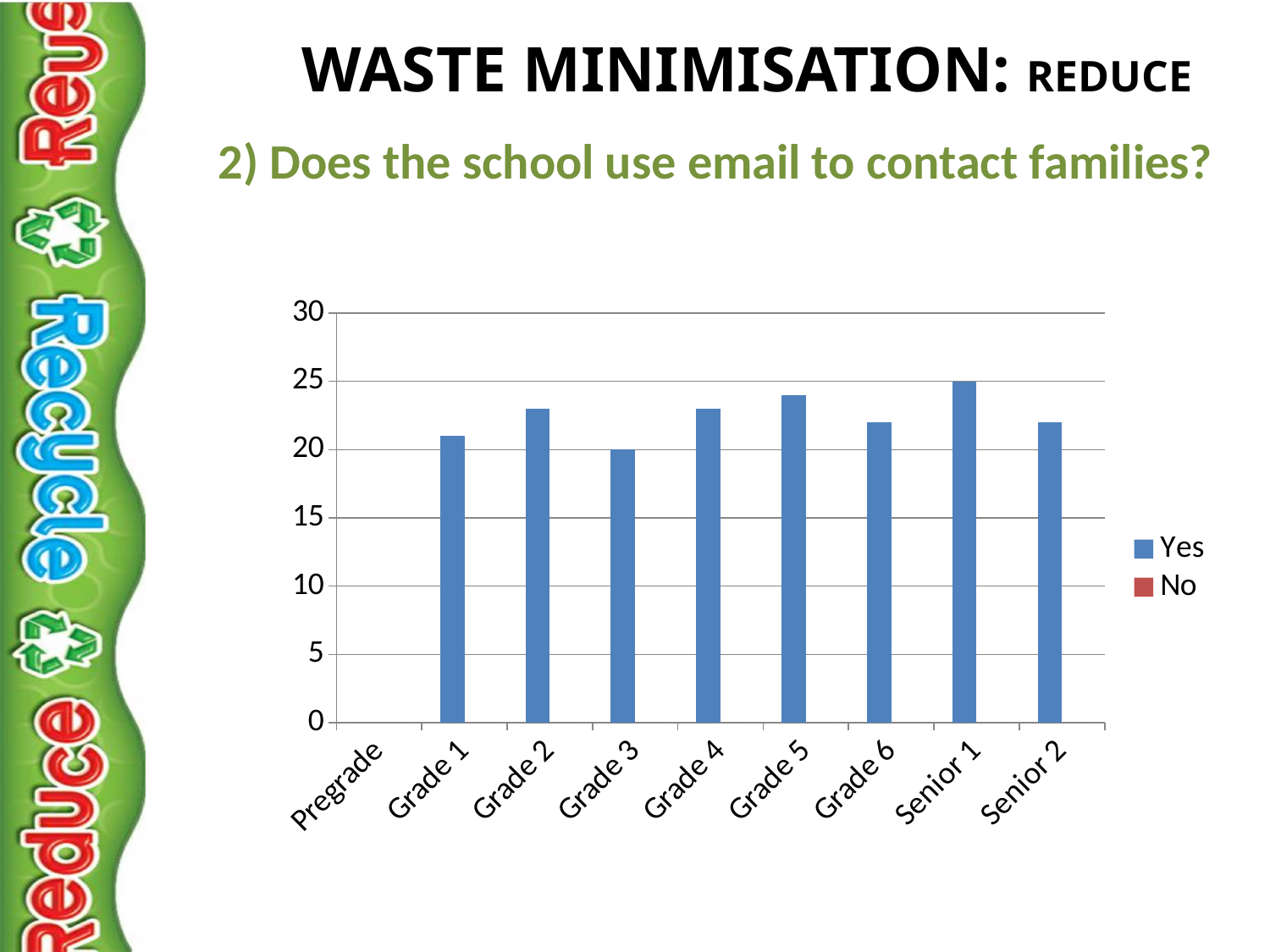
How many categories are shown on the x axis of the chart? 9 Which category has the highest 'Yes' bar? Senior 1 Which has a larger 'Yes' value, Grade 1 or Grade 5? Grade 5 What is the difference between the 'Yes' values for Senior 1 and Grade 3? 5 How many series does the chart's legend list? 2 Is the 'Yes' value for Grade 5 greater or less than 25? less Is the 'Yes' value for Grade 2 greater or less than 20? greater What is the 'Yes' value for Senior 1? 25 What kind of chart is shown on the slide? bar chart What colour are the 'Yes' bars in the chart? blue What are the two entries in the chart's legend? Yes and No What is the 'Yes' value for Grade 3? 20